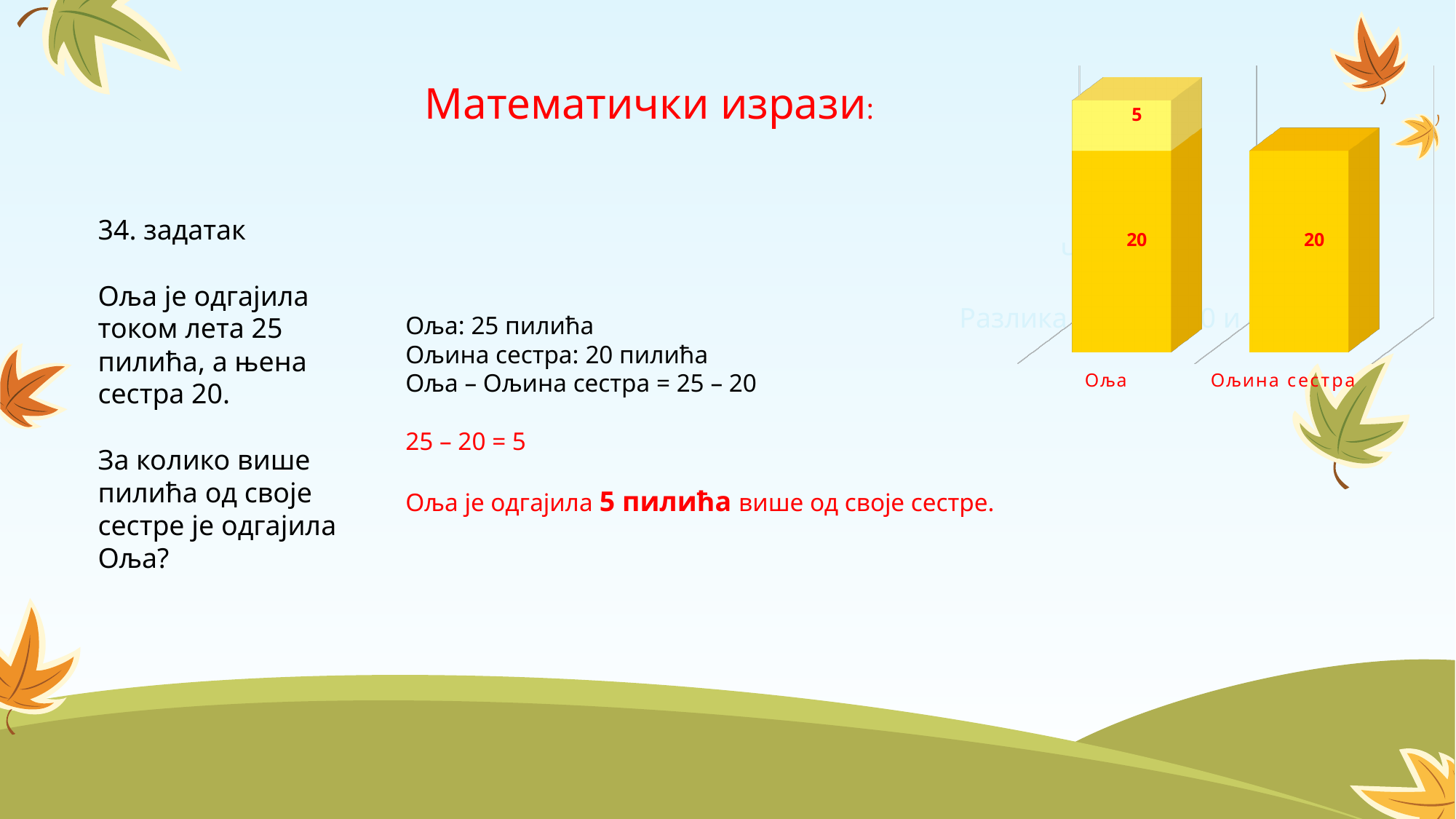
Which category has the highest bar total? Оља How many categories are shown on the x axis of the chart? 2 What is the value shown on the bar for Ољина сестра? 20 What is the value of the upper (lighter) segment of the bar for Оља? 5 What is the value of the lower (darker) segment of the bar for Оља? 20 What are the two category labels on the x axis of the chart? Оља and Ољина сестра Which category has the lowest bar total? Ољина сестра What is the difference between the total for Оља and the value for Ољина сестра? 5 In what colour are the data labels on the bars printed? red What is the total of the stacked bar for Оља? 25 What kind of chart is shown on the slide? bar chart Which category has the taller bar, Оља or Ољина сестра? Оља